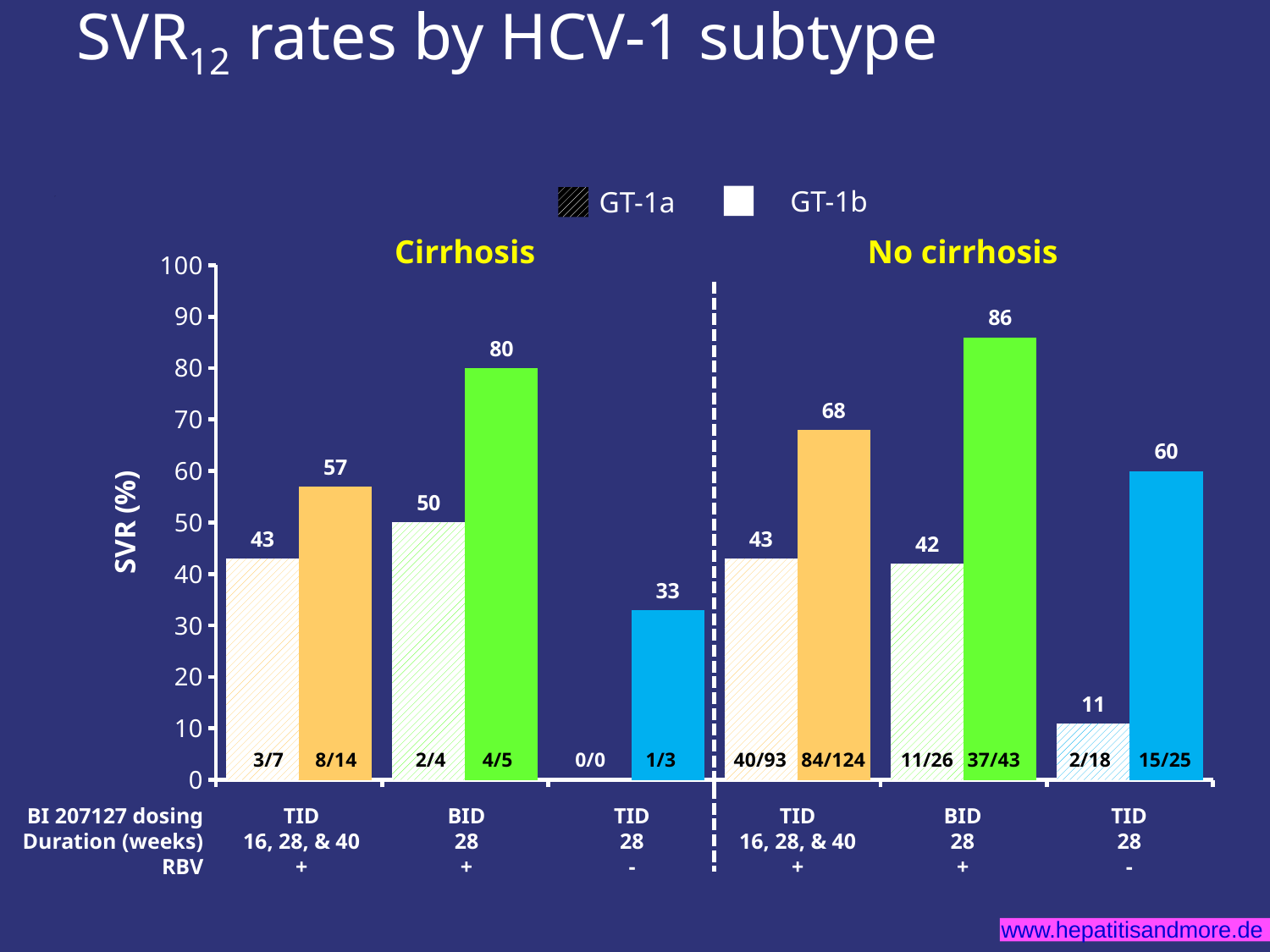
Which bar has the highest SVR rate on the chart? GT-1b, no cirrhosis, BID 28 weeks with RBV (86) What is the label of the y-axis? SVR (%) What is the SVR rate for GT-1a in the no-cirrhosis TID 28-week group without RBV? 11 What is the difference between the GT-1b and GT-1a SVR rates in the no-cirrhosis BID 28-week group? 44 What is the SVR rate for GT-1a in the cirrhosis BID 28-week group with RBV? 50 How many patients are represented by the GT-1b bar in the no-cirrhosis TID 16, 28, & 40-week group (n/N)? 84/124 What type of chart is shown on the slide? bar chart Which is larger: the GT-1b SVR rate in the cirrhosis TID 28-week group without RBV, or the GT-1b rate in the no-cirrhosis TID 28-week group without RBV? No cirrhosis (60) What is the SVR rate for GT-1b in the no-cirrhosis TID 16, 28, & 40-week group with RBV? 68 How many series does the legend list? 2 What is the SVR rate for GT-1b in the cirrhosis BID 28-week group with RBV? 80 What are the two labels shown in the legend? GT-1a and GT-1b